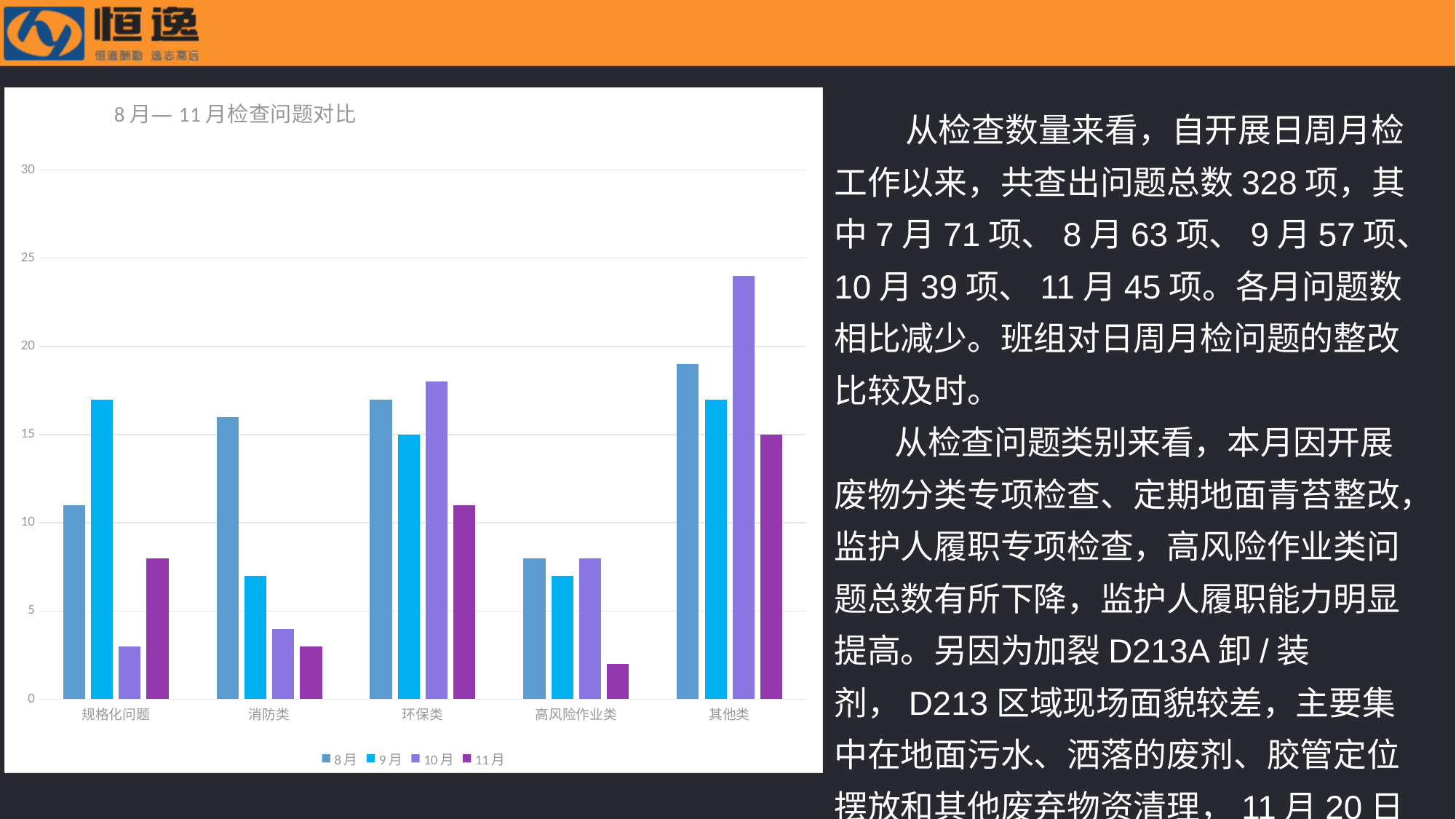
In the 环保类 category, which is larger, the value for 10月 or the value for 11月? 10月 Is the value for 8月 in the 其他类 category greater or less than 15? greater How many categories are shown on the x axis of the chart? 5 Which month has the highest value in the 其他类 category? 10月 Is the value for 10月 in the 规格化问题 category greater or less than 5? less What kind of chart is shown on the slide? bar chart In the 消防类 category, which is larger, the value for 8月 or the value for 9月? 8月 Is the value for 10月 in the 其他类 category greater or less than 20? greater Which month has the lowest value in the 规格化问题 category? 10月 How many series does the chart's legend list? 4 What is the title of the chart? 8月—11月检查问题对比